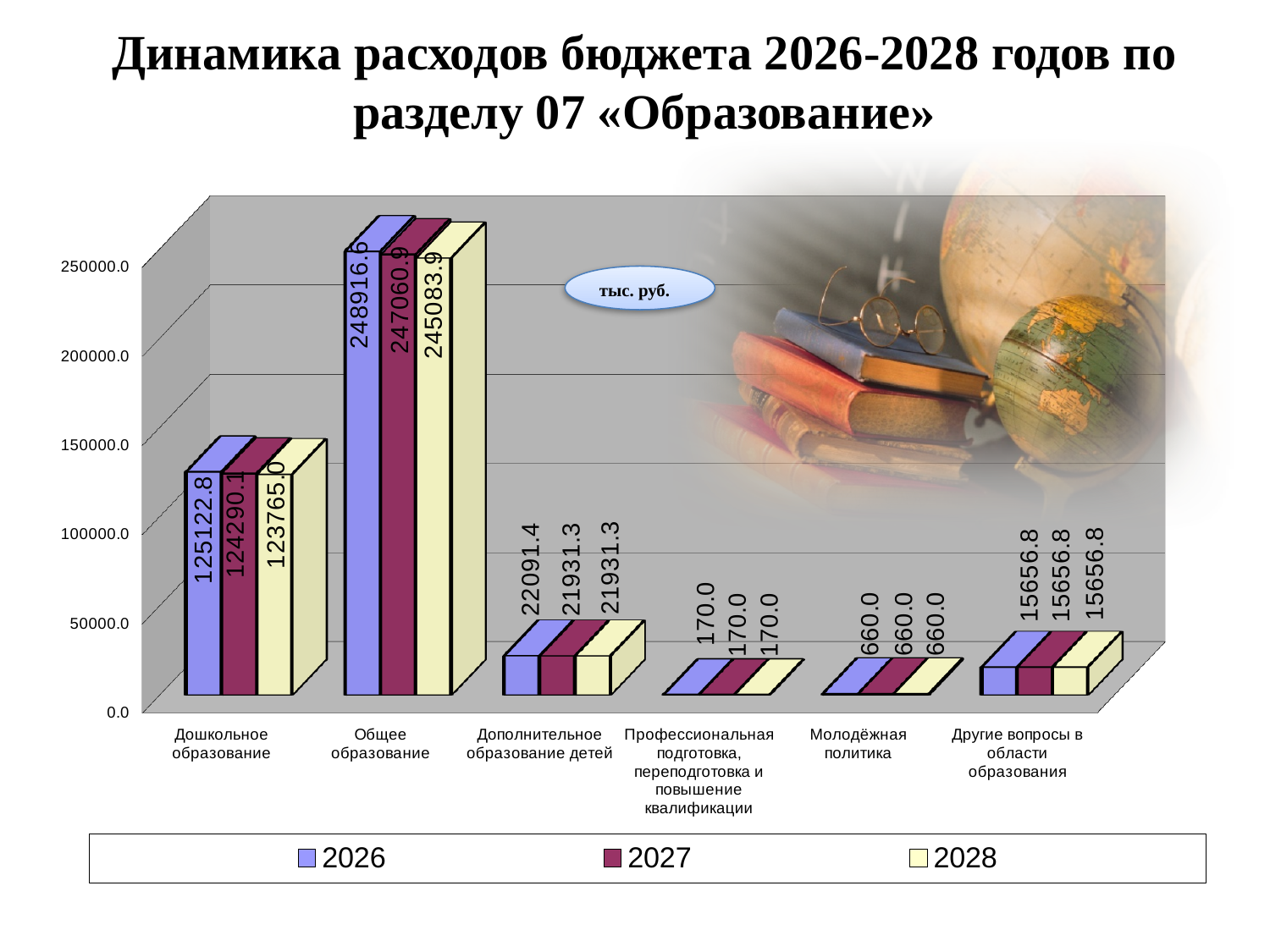
Which category has the highest value in 2026? Общее образование What is the value for Молодёжная политика in 2026? 660.0 What is the value for Дополнительное образование детей in 2027? 21931.3 How many series does the legend list? 3 Which category has the lowest value in 2027? Профессиональная подготовка, переподготовка и повышение квалификации How many categories are shown on the x axis? 6 Do the values for Дошкольное образование rise or fall from 2026 to 2028? fall What is the value for Дошкольное образование in 2026? 125122.8 What is the value for Общее образование in 2028? 245083.9 What is the difference between the 2026 and 2028 values for Дошкольное образование? 1357.8 What is the value for Другие вопросы в области образования in 2028? 15656.8 Which is larger: the 2026 value for Общее образование or the 2027 value for Общее образование? 2026